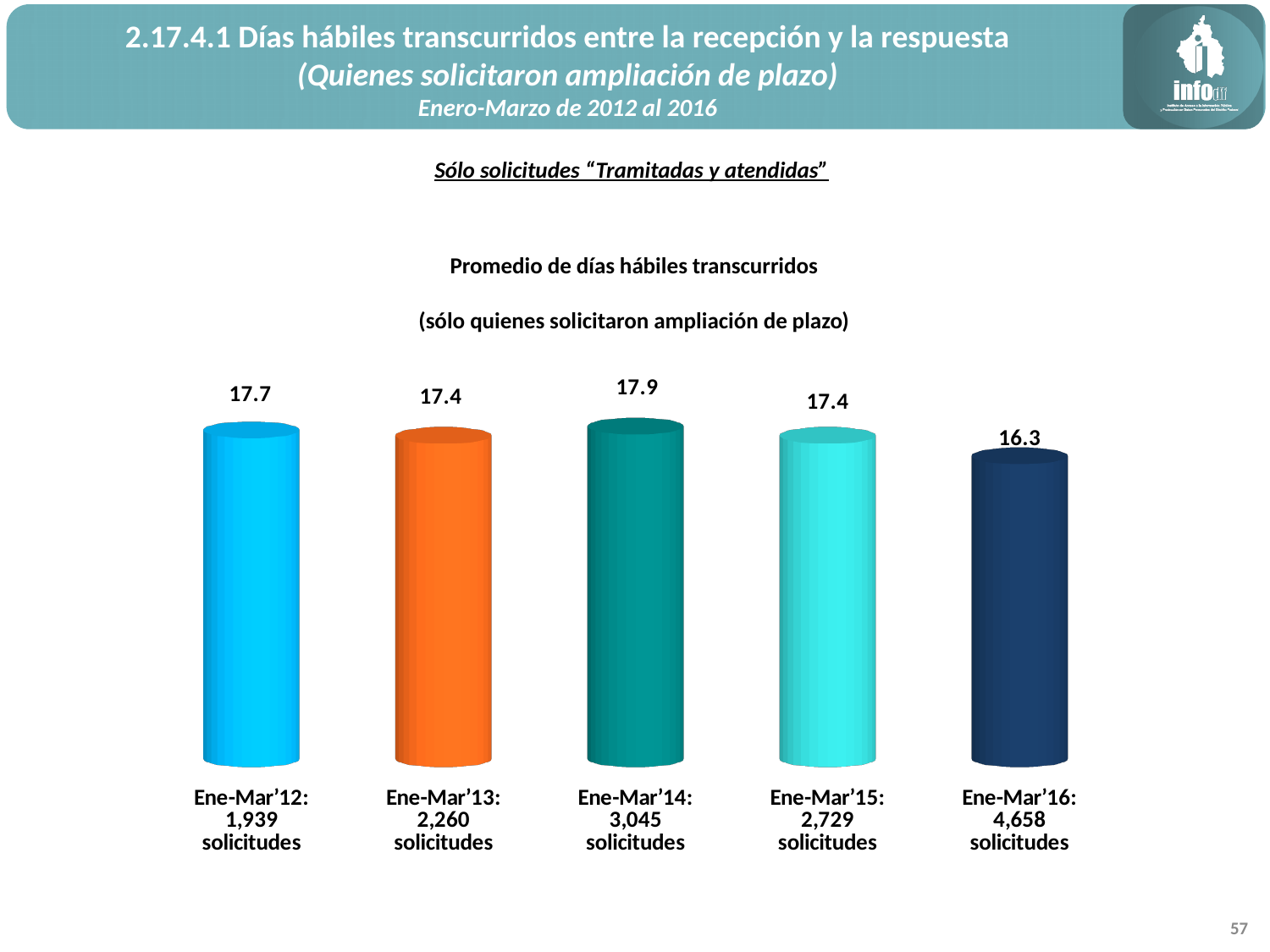
Which period has the highest average number of business days elapsed? Ene-Mar'14 What is the difference between the values for Ene-Mar'14 and Ene-Mar'16? 1.6 Which is larger, the value for Ene-Mar'12 or the value for Ene-Mar'16? Ene-Mar'12 Which period has the lowest average number of business days elapsed? Ene-Mar'16 What is the value shown for Ene-Mar'13? 17.4 What is the value shown for Ene-Mar'14? 17.9 What is the value shown for Ene-Mar'16? 16.3 What is the difference between the values for Ene-Mar'12 and Ene-Mar'13? 0.3 What kind of chart is shown on the slide? Bar chart How many solicitudes are indicated for the Ene-Mar'16 period in the category label? 4,658 solicitudes What is the average number of business days elapsed for Ene-Mar'12? 17.7 How many periods (bars) are shown in the chart? 5